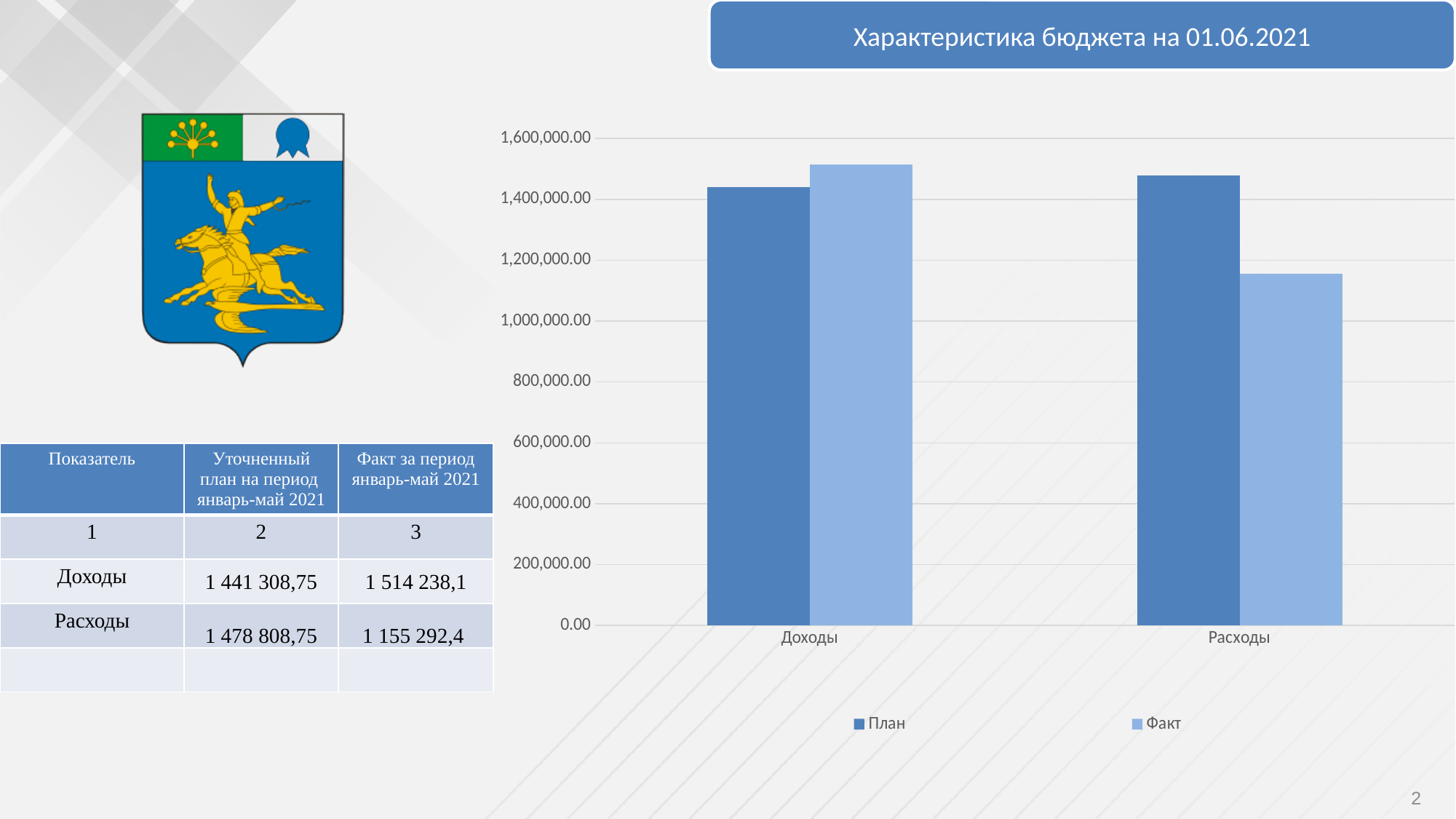
What kind of chart is shown on the slide? bar chart How many categories are shown on the x axis of the chart? 2 What is the title shown above the chart? Характеристика бюджета на 01.06.2021 Is the План value for Доходы greater or less than 1,400,000.00? greater According to the table on the slide, what is the Факт value for Доходы for January–May 2021? 1 514 238,1 For Расходы, which is larger: План or Факт? План What are the two series named in the chart legend? План and Факт For Доходы, which is larger: План or Факт? Факт Which bar in the chart is the lowest? Факт for Расходы Is the План value for Расходы greater or less than 1,400,000.00? greater Is the Факт value for Расходы greater or less than 1,200,000.00? less How many series does the chart legend list? 2